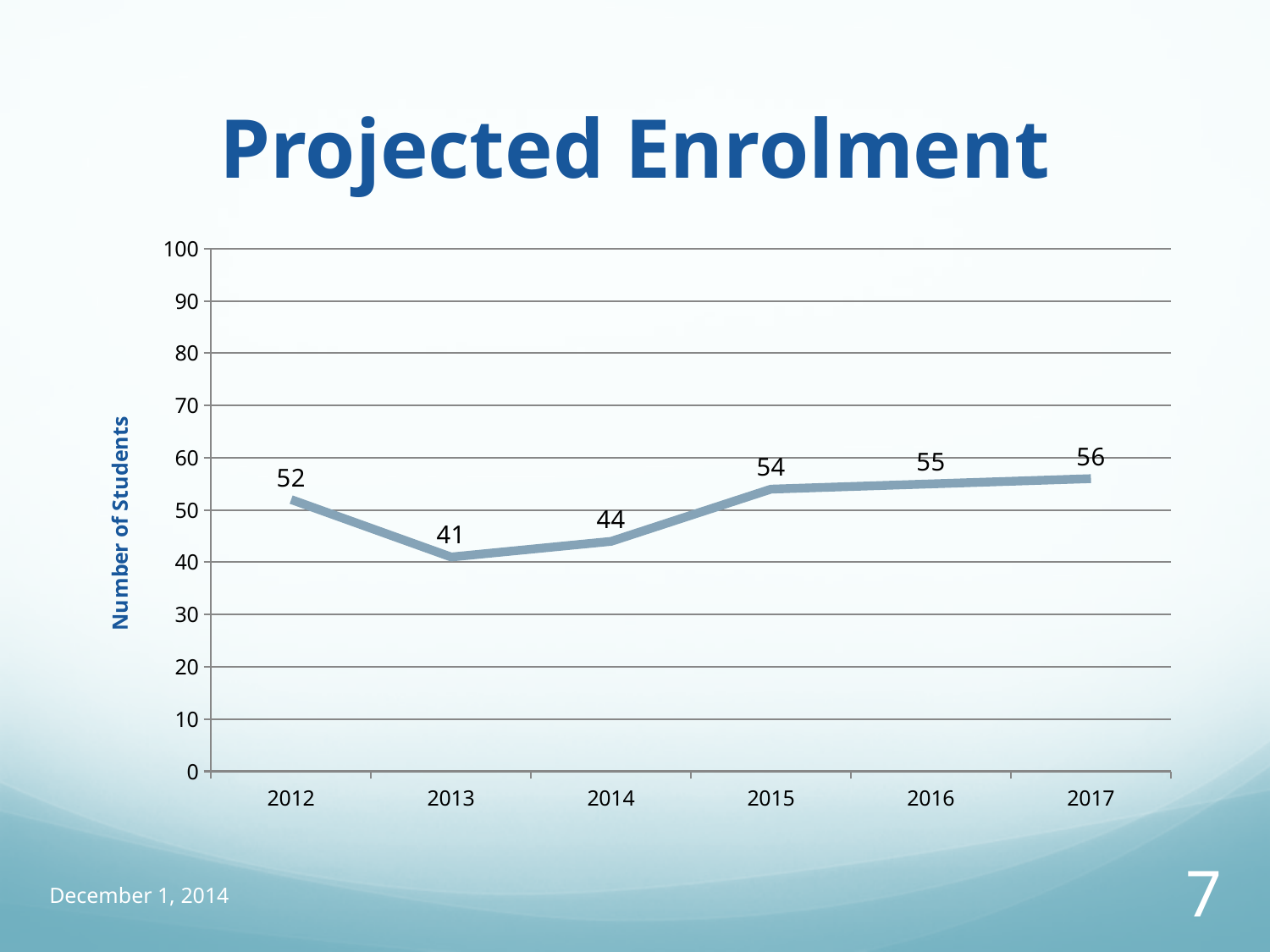
What is the label on the vertical axis of the chart? Number of Students What is the projected enrolment for 2013? 41 What is the number of students shown for 2016? 55 What is the value plotted for 2012? 52 Which year has a larger enrolment, 2012 or 2014? 2012 By how much does the enrolment change from 2012 to 2013? 11 What kind of chart is shown on the slide? Line chart Which year has the highest projected enrolment? 2017 Is the value for 2015 greater or less than 50? greater Which year has the lowest projected enrolment? 2013 What is the difference between the enrolment in 2017 and the enrolment in 2013? 15 How many years are plotted on the chart? 6